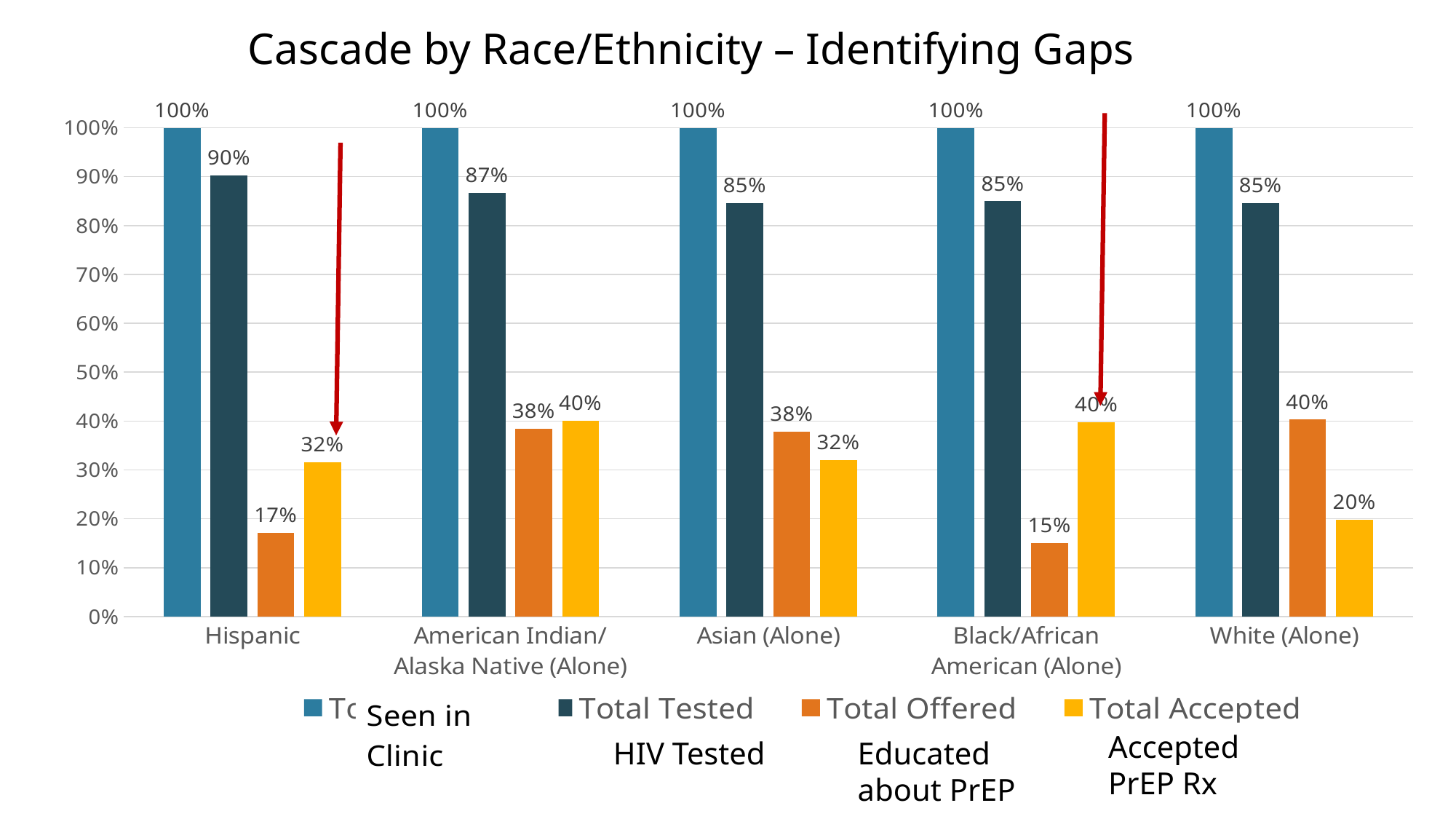
Is the Total Accepted value larger for Asian (Alone) or for White (Alone)? Asian (Alone) What is the difference between Total Offered and Total Accepted for Black/African American (Alone)? 25% What is the Total Tested value for Hispanic? 90% Which category has the highest Total Tested value? Hispanic How many series does the legend list? 4 What kind of chart is shown on the slide? Bar chart What is the Total Accepted value for White (Alone)? 20% How many race/ethnicity categories are shown on the x axis? 5 What is the Total Offered value for American Indian/Alaska Native (Alone)? 38% Which category has the lowest Total Offered value? Black/African American (Alone) What is the Total Offered value for Black/African American (Alone)? 15% What is the title of the chart? Cascade by Race/Ethnicity – Identifying Gaps